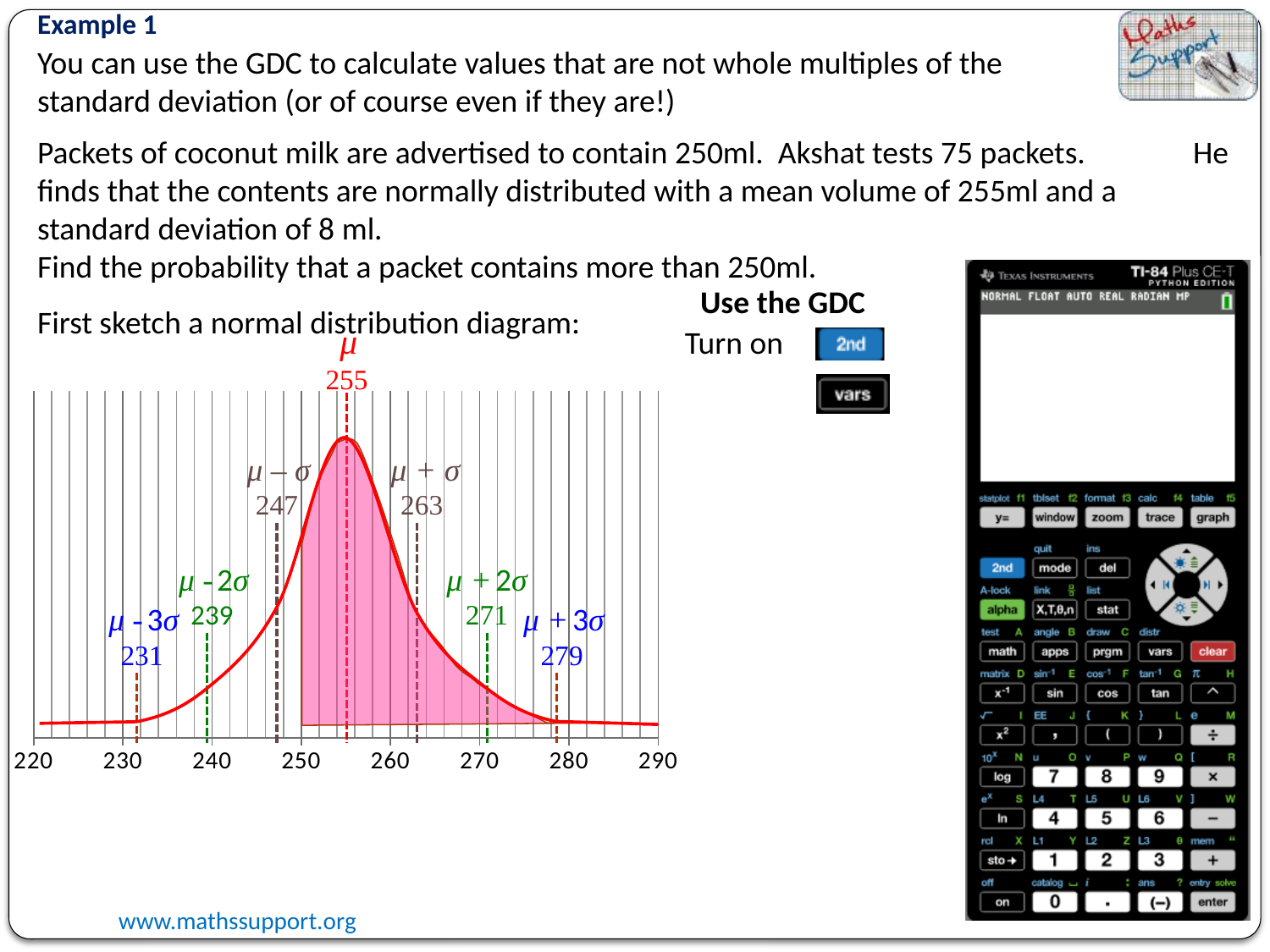
What value is labelled at the mean (μ) on the normal distribution diagram? 255 What value is labelled at μ − 3σ on the diagram? 231 What value is labelled at μ + 2σ on the diagram? 271 What value is labelled at μ − σ on the diagram? 247 What is the difference between the values labelled at μ + σ and μ − σ on the diagram? 16 What value is labelled at μ + 3σ on the diagram? 279 What are the lowest and highest values shown on the x axis of the diagram? 220 and 290 What value is labelled at μ − 2σ on the diagram? 239 How many labelled dashed vertical lines (μ and the σ multiples) are marked on the diagram? 7 What is the difference between the values labelled at μ + 3σ and μ − 3σ on the diagram? 48 From which x-axis value does the pink shaded region under the curve begin? 250 What value is labelled at μ + σ on the diagram? 263